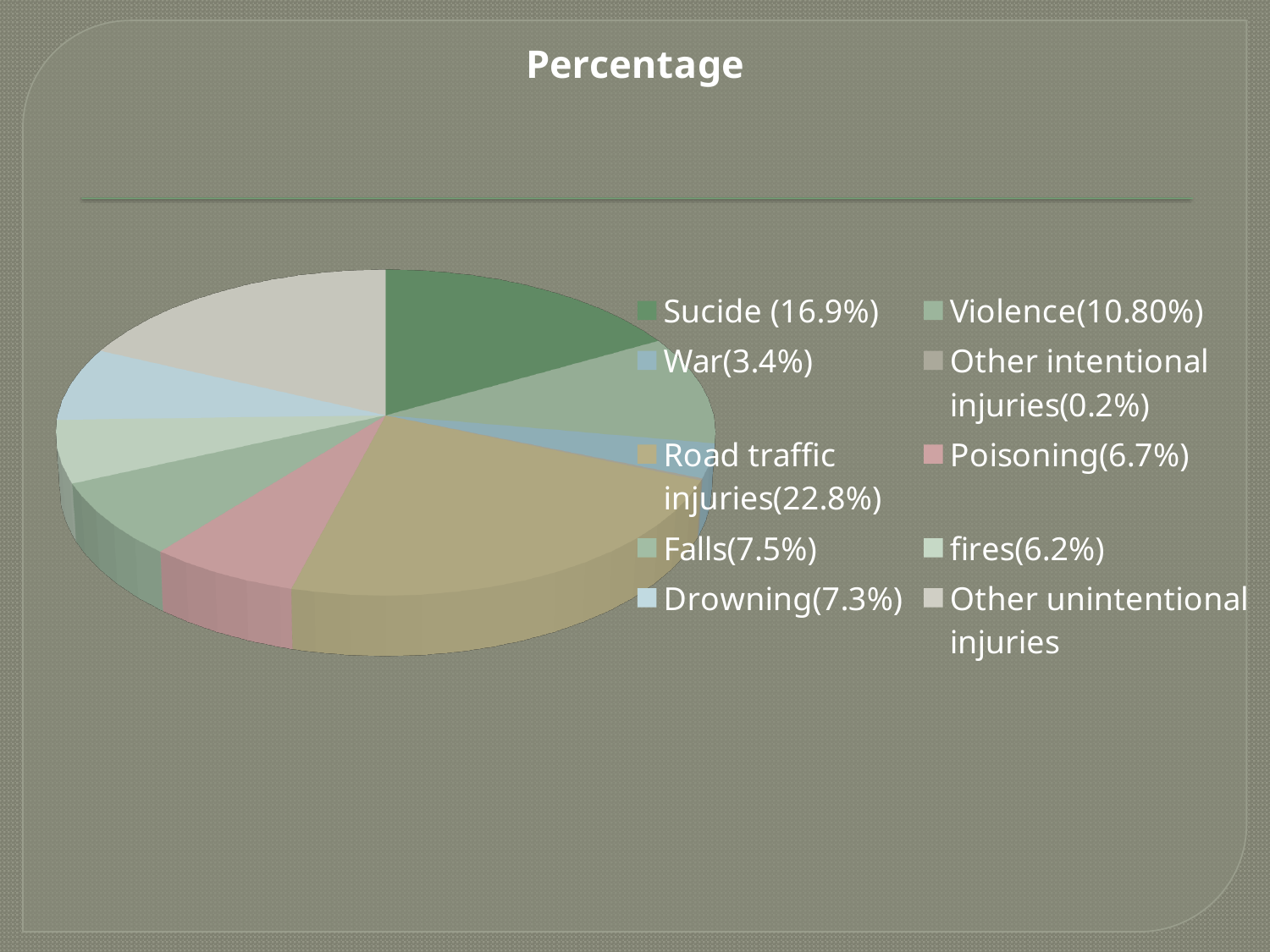
Which category has the largest share of the pie? Road traffic injuries Which is larger, the share for Sucide or the share for Violence? Sucide What percentage is given for Poisoning? 6.7% How many categories does the pie chart's legend list? 10 What percentage is given for Road traffic injuries? 22.8% What is the title of the chart? Percentage What is the difference in percentage points between Road traffic injuries and Sucide? 5.9 What kind of chart is shown on the slide? Pie chart What percentage is given for Violence? 10.80% Which category has the smallest share of the pie? Other intentional injuries What percentage is given for War? 3.4% What percentage is given for Sucide? 16.9%